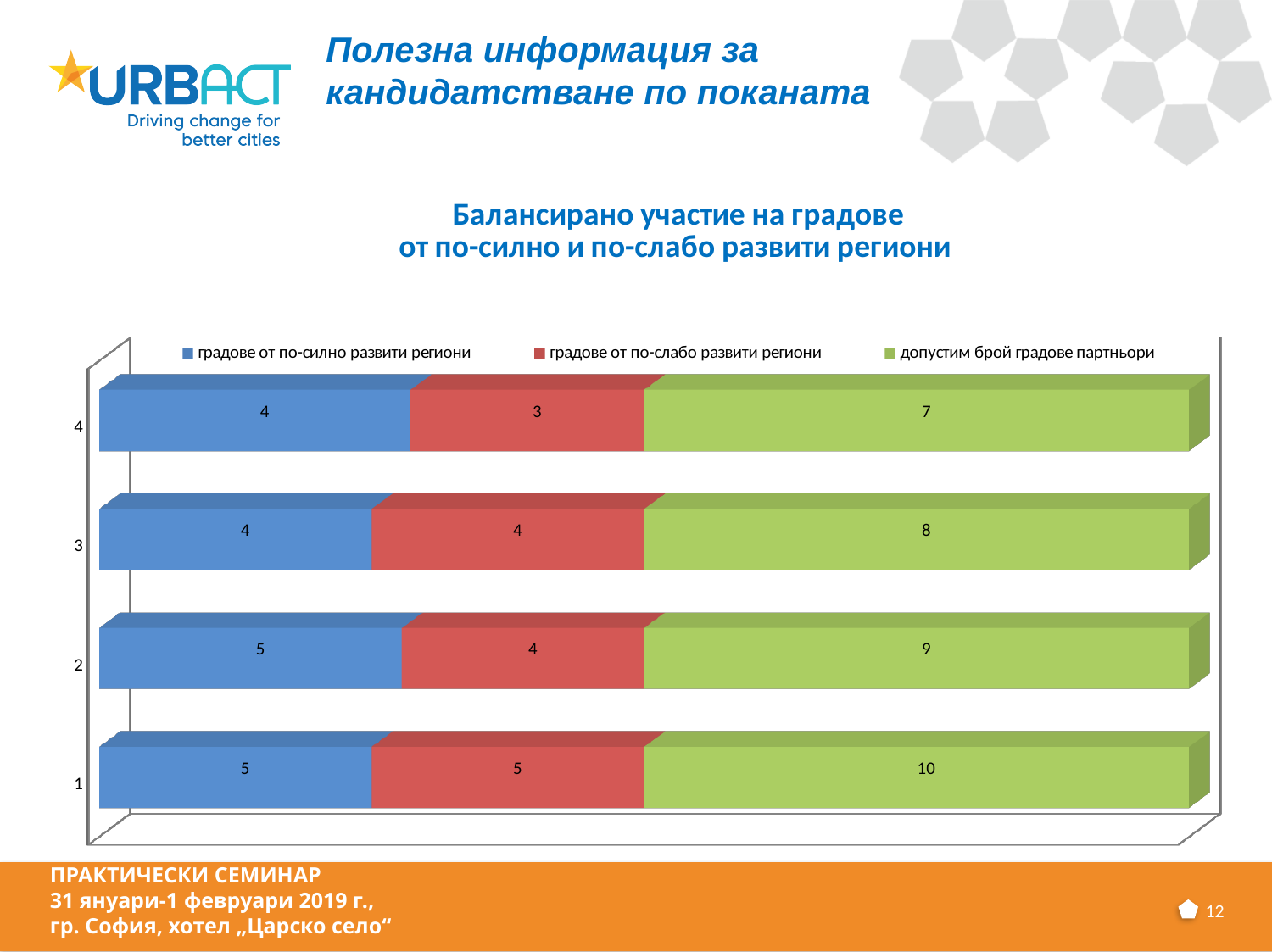
What is the value of "градове от по-слабо развити региони" for category 4? 3 Which colour represents "допустим брой градове партньори" in the chart? green How many categories are shown on the vertical axis? 4 Which category has the lowest value for "градове от по-слабо развити региони"? 4 What is the value of "допустим брой градове партньори" for category 1? 10 Which is larger for category 2: "градове от по-силно развити региони" or "градове от по-слабо развити региони"? градове от по-силно развити региони What is the difference between "допустим брой градове партньори" for category 1 and category 4? 3 What is the total of the stacked bar for category 4? 14 What is the value of "градове от по-силно развити региони" for category 2? 5 What type of chart is shown on the slide? stacked bar chart Which category has the highest value for "допустим брой градове партньори"? 1 How many series does the legend list? 3